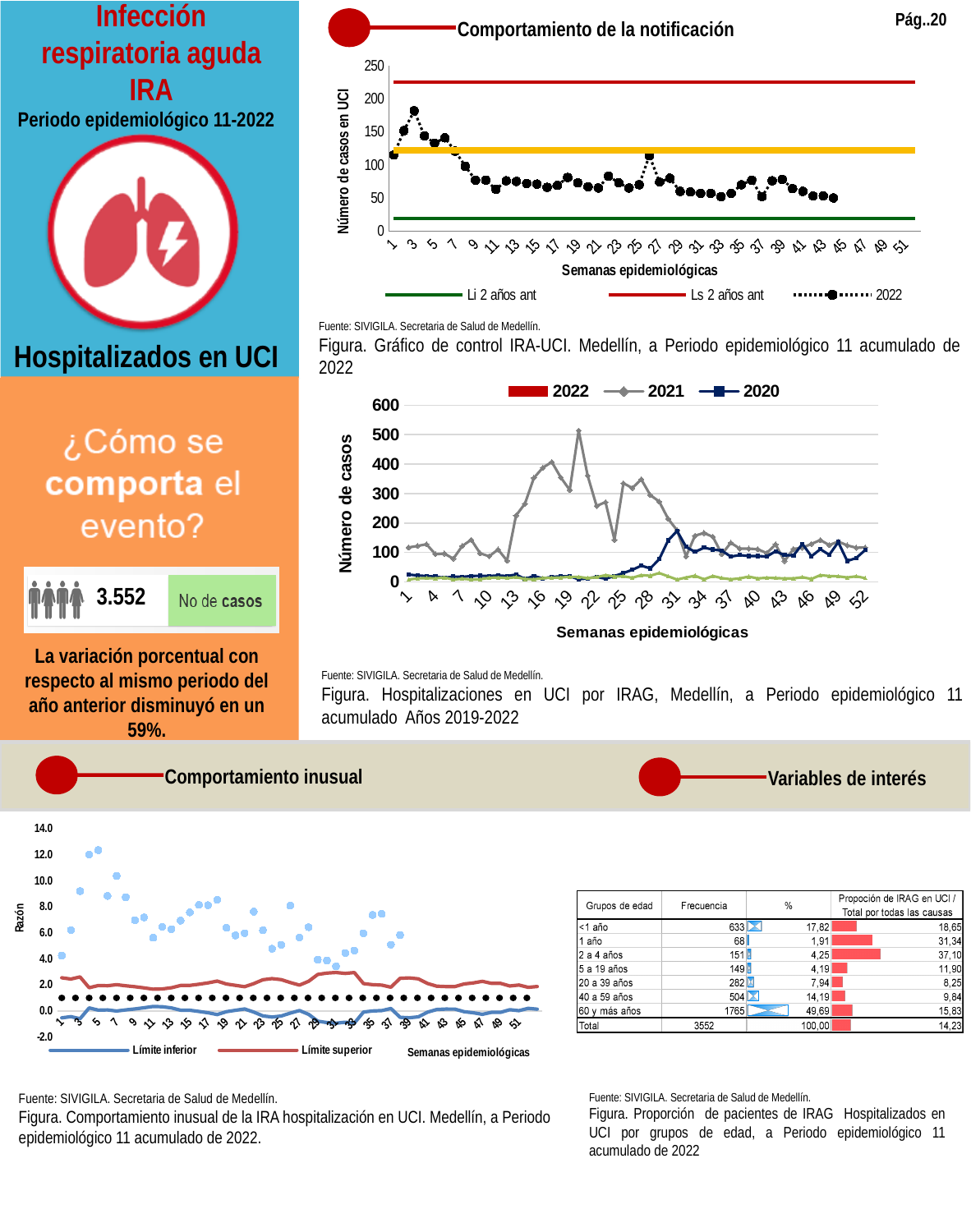
In the bottom-left chart 'Comportamiento inusual', how many series does the legend list? 2 In the middle chart of hospitalizations in UCI por IRAG, what kind of chart is it? combination bar and line chart In the top chart 'Comportamiento de la notificación', what is the label of the series drawn as a green line? Li 2 años ant In the top chart 'Comportamiento de la notificación', what is the highest value shown on the y axis? 250 In the middle chart of hospitalizations in UCI por IRAG, how many series does the legend list? 3 In the top chart 'Comportamiento de la notificación', how many series does the legend list? 3 In the top chart 'Comportamiento de la notificación', is the 2022 value at week 3 greater or less than 150? greater In the middle chart of hospitalizations in UCI por IRAG, is the peak value of the 2021 series greater or less than 400? greater In the middle chart of hospitalizations in UCI por IRAG, which series reaches the highest value, 2020, 2021 or 2022? 2021 In the bottom-left chart 'Comportamiento inusual', is the Razón value at week 4 greater or less than 10.0? greater